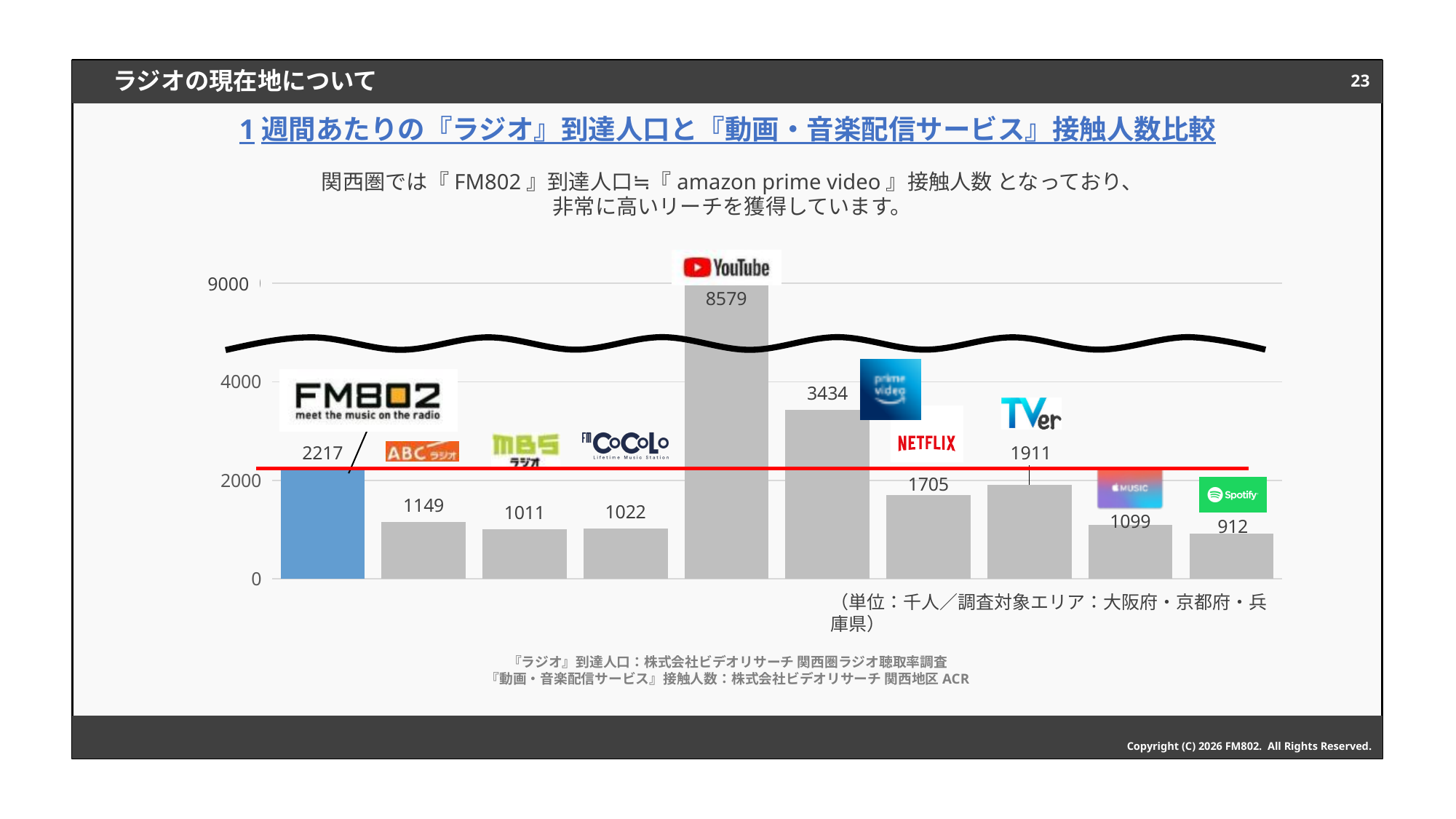
Which is larger, the value for TVer or the value for Netflix? TVer What is the value shown for Netflix? 1705 What is the value shown for Spotify? 912 What is the value shown for FM802? 2217 What colour is the FM802 bar compared with the other bars? blue; the others are grey Is the value for ABC ラジオ greater or less than 2000? less What is the value shown for YouTube? 8579 What is the difference between the values for Prime Video and FM802? 1217 What kind of chart is shown on the slide? bar chart Which service has the lowest value in the chart? Spotify Which service has the highest value in the chart? YouTube How many bars are shown in the chart? 10